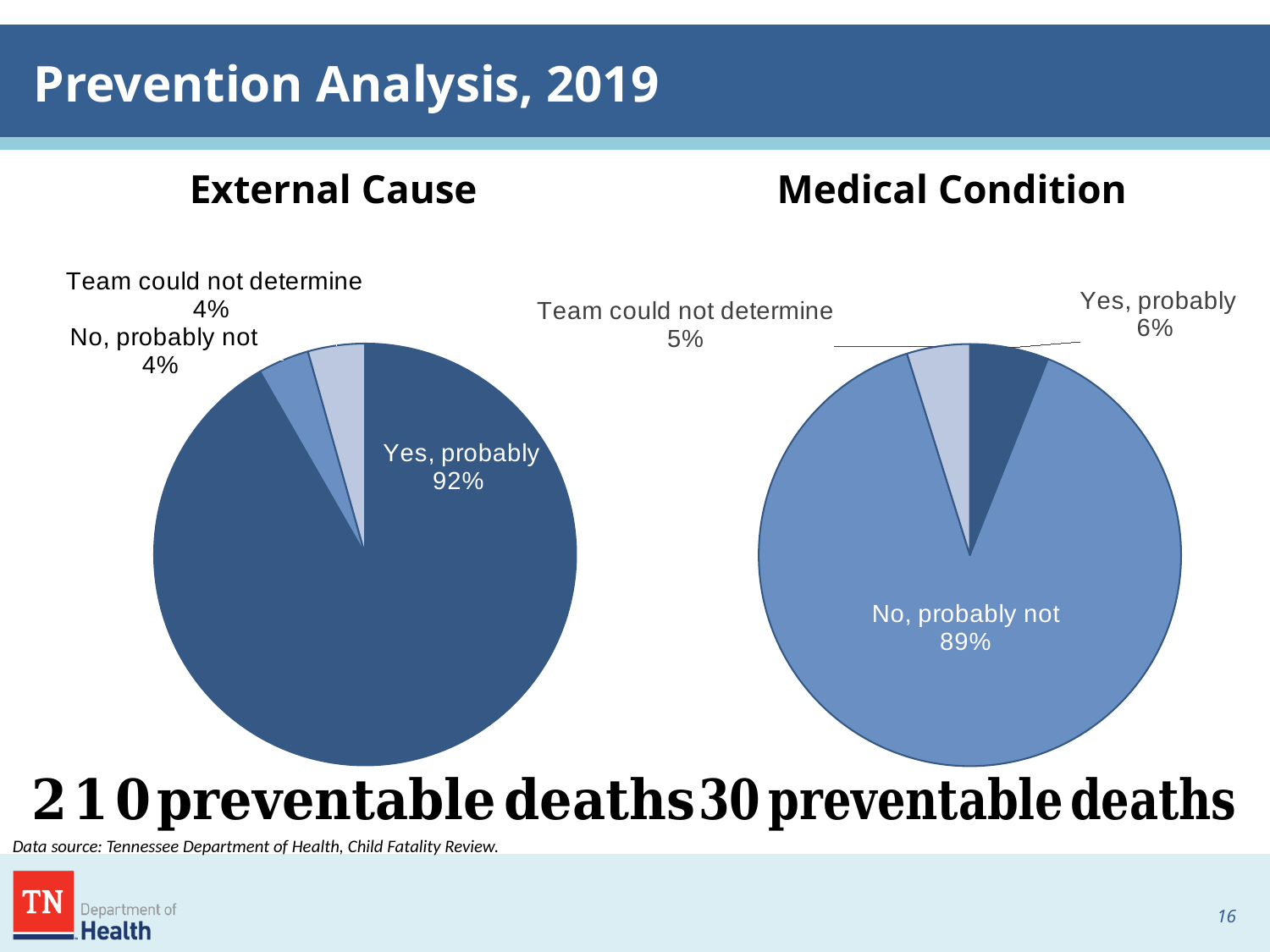
In the Medical Condition pie chart, which category has the smallest slice? Team could not determine What type of chart is used for the Medical Condition data? Pie chart How many slices does the External Cause pie chart have? 3 In the Medical Condition pie chart, what share is labelled "No, probably not"? 89% In the External Cause pie chart, what share is labelled "No, probably not"? 4% In the Medical Condition pie chart, which category has the largest slice? No, probably not In the External Cause pie chart, which category has the largest slice? Yes, probably What is the difference between the "Yes, probably" share in the External Cause chart and the "Yes, probably" share in the Medical Condition chart? 86% Which is larger: the "Team could not determine" share in the External Cause chart or in the Medical Condition chart? Medical Condition In the External Cause pie chart, what share is labelled "Yes, probably"? 92% In the Medical Condition pie chart, what share is labelled "Yes, probably"? 6% In the Medical Condition pie chart, what share is labelled "Team could not determine"? 5%